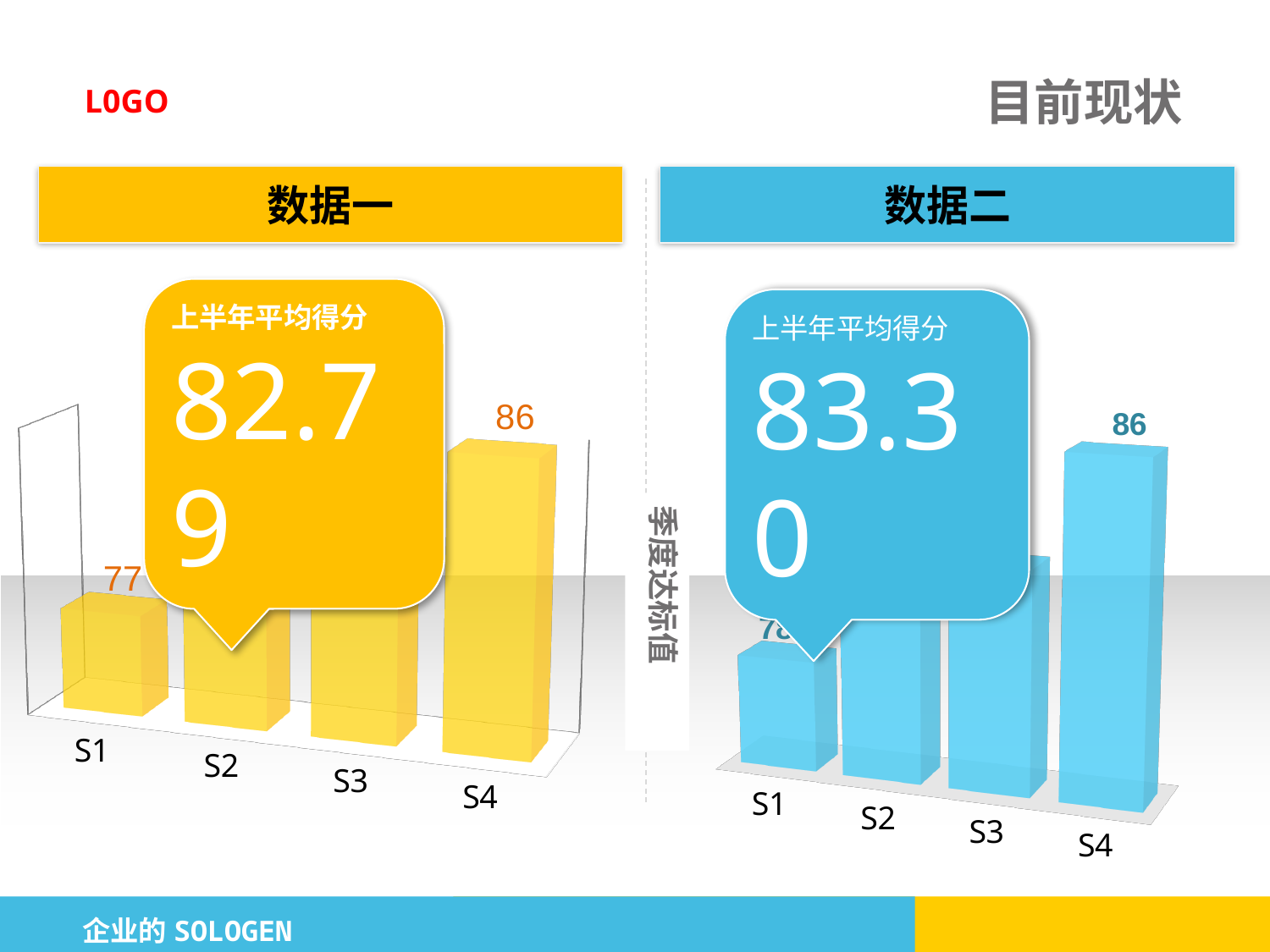
In the 数据二 chart on the right, which category has the lowest value? S1 In the 数据一 chart on the left, which category has the highest value? S4 In the 数据一 chart on the left, which is larger, the value for S1 or the value for S4? S4 How many categories are shown in the 数据二 chart on the right? 4 In the 数据一 chart on the left, what is the difference between the values for S4 and S1? 9 In the 数据二 chart on the right, which category has the highest value? S4 In the 数据二 chart on the right, what is the value for S4? 86 In the 数据二 chart on the right, do the values rise or fall from S1 to S4? Rise In the 数据一 chart on the left, which category has the lowest value? S1 In the 数据一 chart on the left, what is the value for S4? 86 In the 数据一 chart on the left, what is the value for S1? 77 What kind of chart is the 数据一 chart on the left? Bar chart